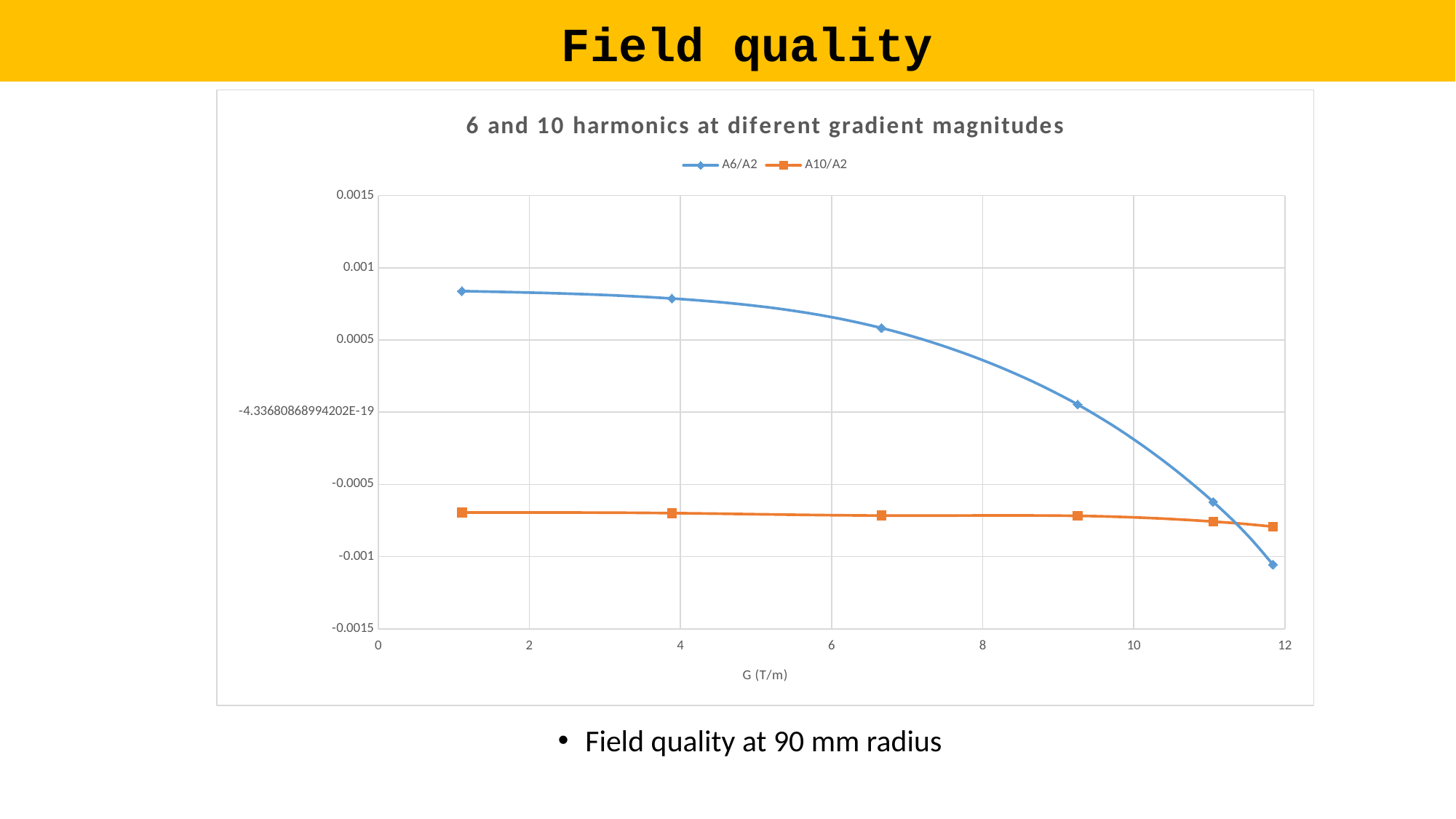
How many series does the legend list? 2 What is the label of the x axis? G (T/m) Does the A6/A2 series rise or fall as G increases? fall What kind of chart is shown on the slide? line chart At the rightmost point (G of about 12), which series has the larger value, A6/A2 or A10/A2? A10/A2 At G of about 4, which series has the larger value, A6/A2 or A10/A2? A6/A2 What are the two series named in the legend? A6/A2 and A10/A2 Is the value of A10/A2 at G of about 4 greater or less than -0.0005? less How many data points are plotted for the A6/A2 series? 6 Is the value of A6/A2 at its rightmost point (G of about 12) greater or less than -0.001? less Is the value of A6/A2 at its leftmost point (G of about 1) greater or less than 0.0005? greater